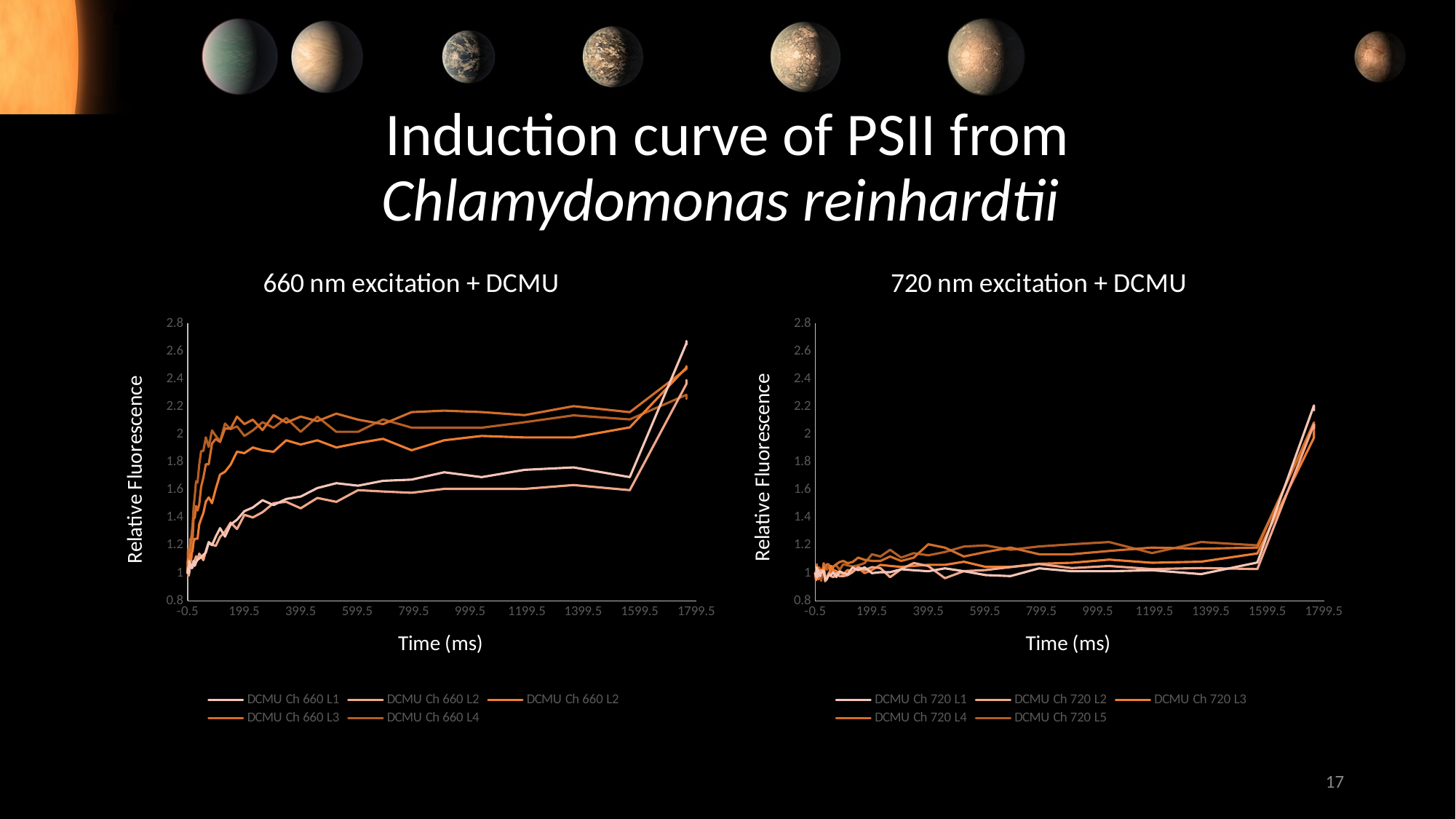
What is the x-axis label of the '660 nm excitation + DCMU' chart? Time (ms) In the '720 nm excitation + DCMU' chart, do the series values overall rise or fall from the start to the end of the time axis? rise What kind of chart is the '660 nm excitation + DCMU' chart? line chart In the '660 nm excitation + DCMU' chart, do the series values overall rise or fall from the start to the end of the time axis? rise How many tick labels are shown on the x axis of the '660 nm excitation + DCMU' chart? 10 How many series does the legend of the '660 nm excitation + DCMU' chart list? 5 In the '720 nm excitation + DCMU' chart, are the values of all series at 999.5 ms greater or less than 1.4? less How many series does the legend of the '720 nm excitation + DCMU' chart list? 5 What kind of chart is the '720 nm excitation + DCMU' chart? line chart In the '660 nm excitation + DCMU' chart, is the highest value reached by any series greater or less than 2.4? greater In the '720 nm excitation + DCMU' chart, is the highest value reached by any series greater or less than 2.4? less What is the y-axis label of the '720 nm excitation + DCMU' chart? Relative Fluorescence